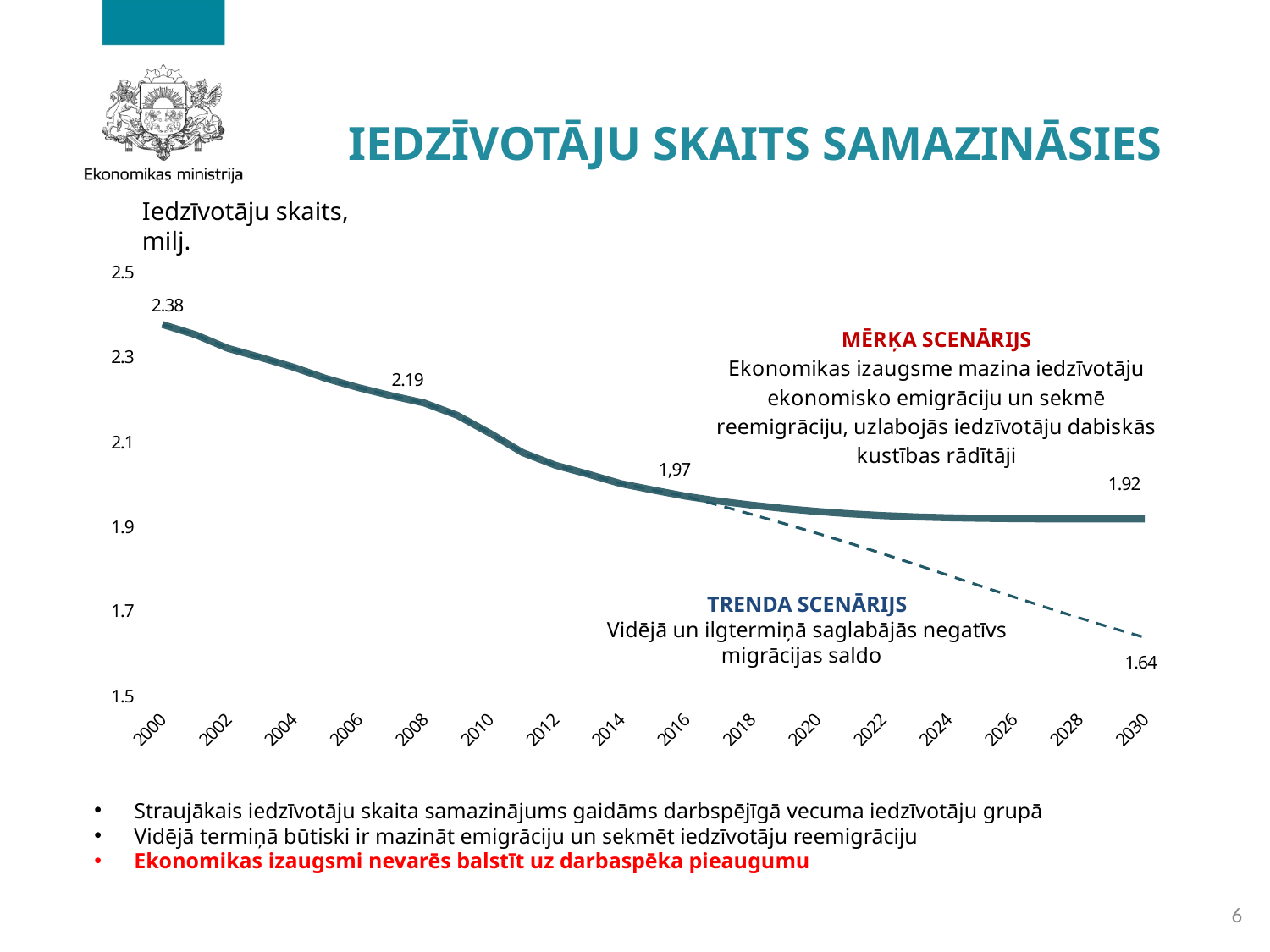
Which scenario has the higher value in 2030, Mērķa scenārijs or Trenda scenārijs? Mērķa scenārijs Does the population line rise or fall from 2000 to 2016? fall By how much does the population fall from 2000 (2.38) to the 2030 Mērķa scenārijs value (1.92)? 0.46 What is the population value labelled for 2008? 2.19 What is the 2030 value for the Mērķa scenārijs (solid line)? 1.92 What value is labelled on the line at 2016? 1,97 What type of chart is shown on the slide? line chart Is the Trenda scenārijs (dashed line) value in 2024 greater or less than 1.9? less What is the difference between the 2030 values of the Mērķa scenārijs and the Trenda scenārijs? 0.28 What is the 2030 value for the Trenda scenārijs (dashed line)? 1.64 What is the title of the slide above the chart? IEDZĪVOTĀJU SKAITS SAMAZINĀSIES What is the population value shown for 2000? 2.38